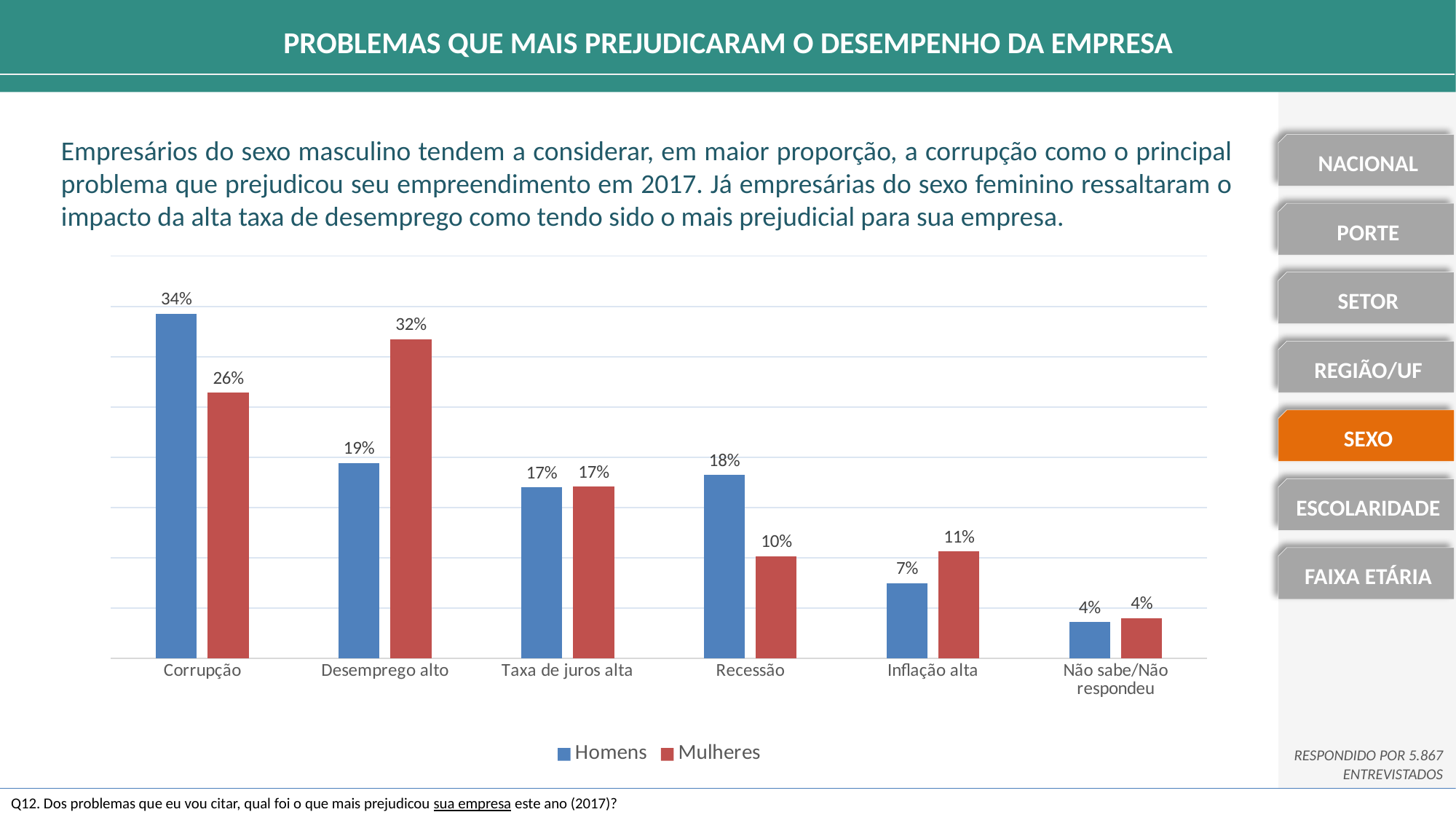
What is the difference between the Mulheres and Homens values for Desemprego alto? 13% What is the difference between the Homens and Mulheres values for Corrupção? 8% Which is larger for Inflação alta: the Homens value or the Mulheres value? Mulheres What kind of chart is shown on the slide? Bar chart Which category has the lowest value for Mulheres? Não sabe/Não respondeu What is the value for Mulheres in the Desemprego alto category? 32% What is the value for Homens in the Corrupção category? 34% Which category has the highest value for Homens? Corrupção How many categories are shown on the x axis? 6 Which series is shown in red in the legend? Mulheres What is the value for Mulheres in the Recessão category? 10% How many series does the legend list? 2